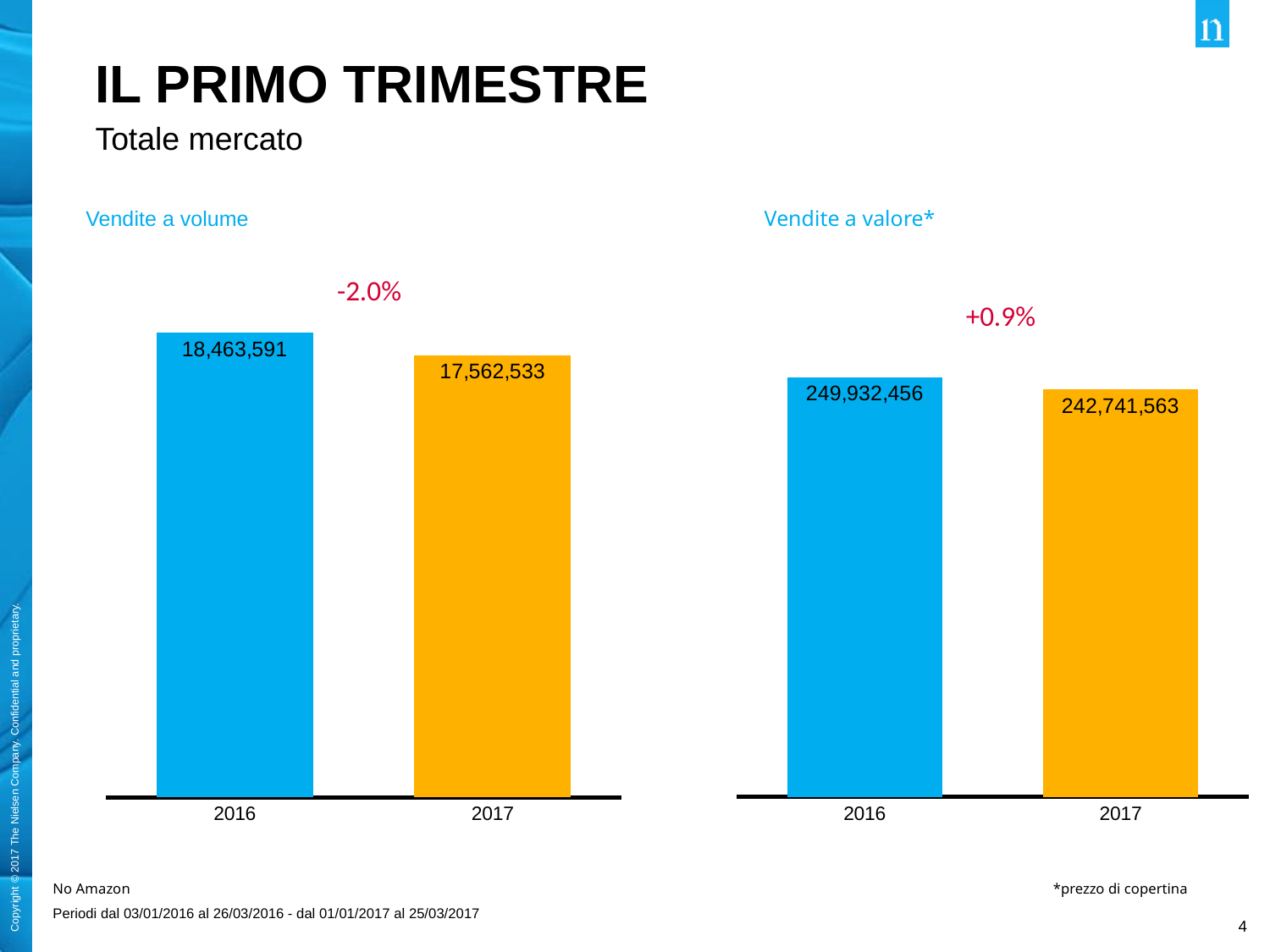
What percentage change is printed above the bars in the 'Vendite a volume' chart? -2.0% In the 'Vendite a volume' chart, what is the difference between the 2016 and 2017 values? 901,058 In the 'Vendite a valore*' chart, what is the value for 2017? 242,741,563 What type of chart is the 'Vendite a valore*' chart? bar chart In the 'Vendite a volume' chart, what is the value for 2016? 18,463,591 How many bars are shown in the 'Vendite a volume' chart? 2 In the 'Vendite a valore*' chart, what is the difference between the 2016 and 2017 values? 7,190,893 In the 'Vendite a valore*' chart, what is the value for 2016? 249,932,456 In the 'Vendite a valore*' chart, is the value for 2016 larger or smaller than the value for 2017? larger In the 'Vendite a volume' chart, which year has the higher value? 2016 In the 'Vendite a valore*' chart, which year has the lower value? 2017 In the 'Vendite a volume' chart, what is the value for 2017? 17,562,533